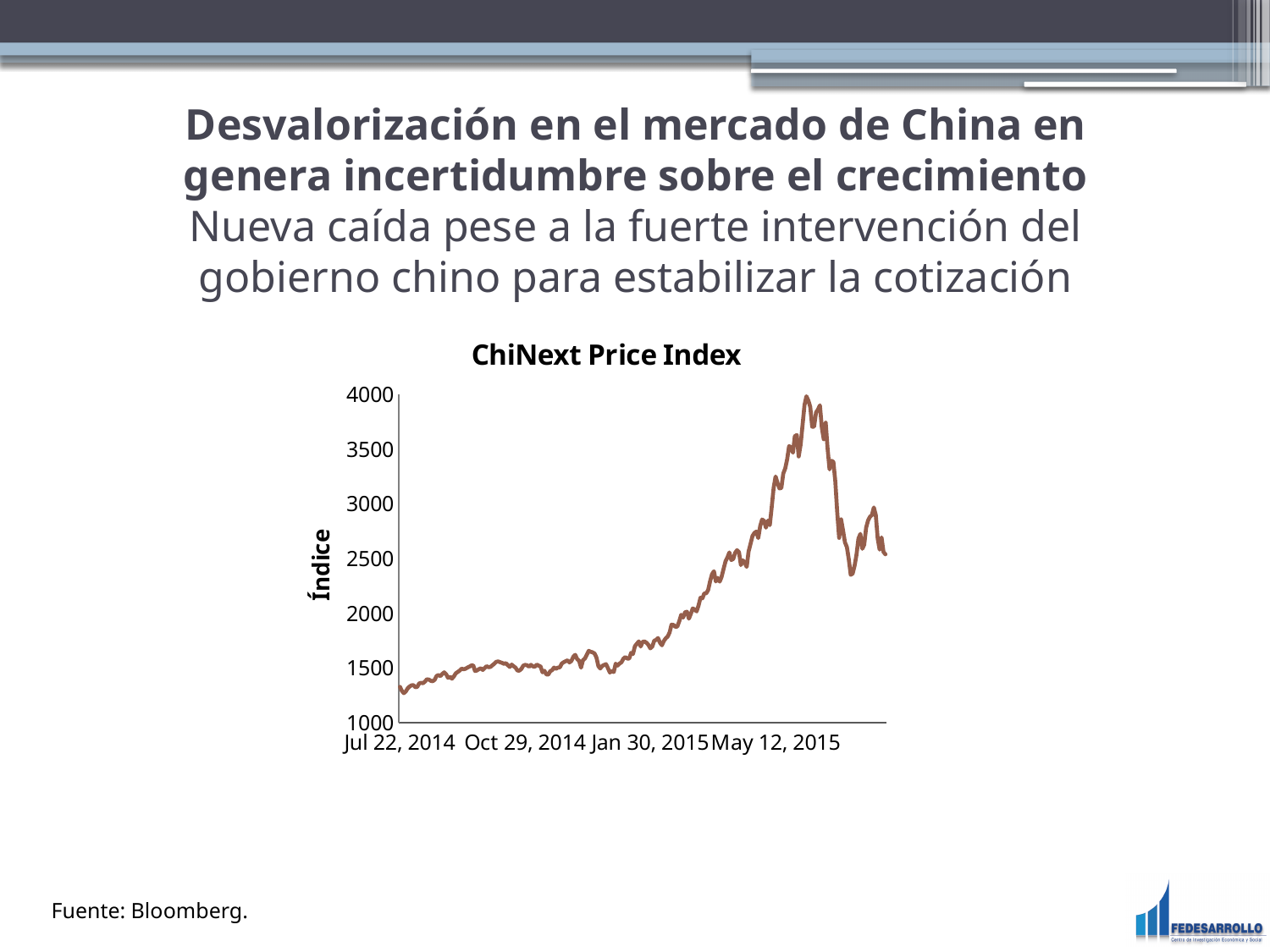
Is the value of the ChiNext Price Index at Jan 30, 2015 greater or less than 2500? less What is the title of the chart? ChiNext Price Index What kind of chart is shown on the slide? line chart Is the value of the ChiNext Price Index at Oct 29, 2014 greater or less than 2000? less Is the value of the ChiNext Price Index at Jul 22, 2014 greater or less than 1500? less After reaching its peak, does the ChiNext Price Index rise or fall toward the end of the series? fall What is the label on the vertical axis of the chart? Índice Does the ChiNext Price Index rise or fall between Jul 22, 2014 and Jan 30, 2015? rise How many date labels are shown on the horizontal axis? 4 What is the highest value shown on the vertical axis of the chart? 4000